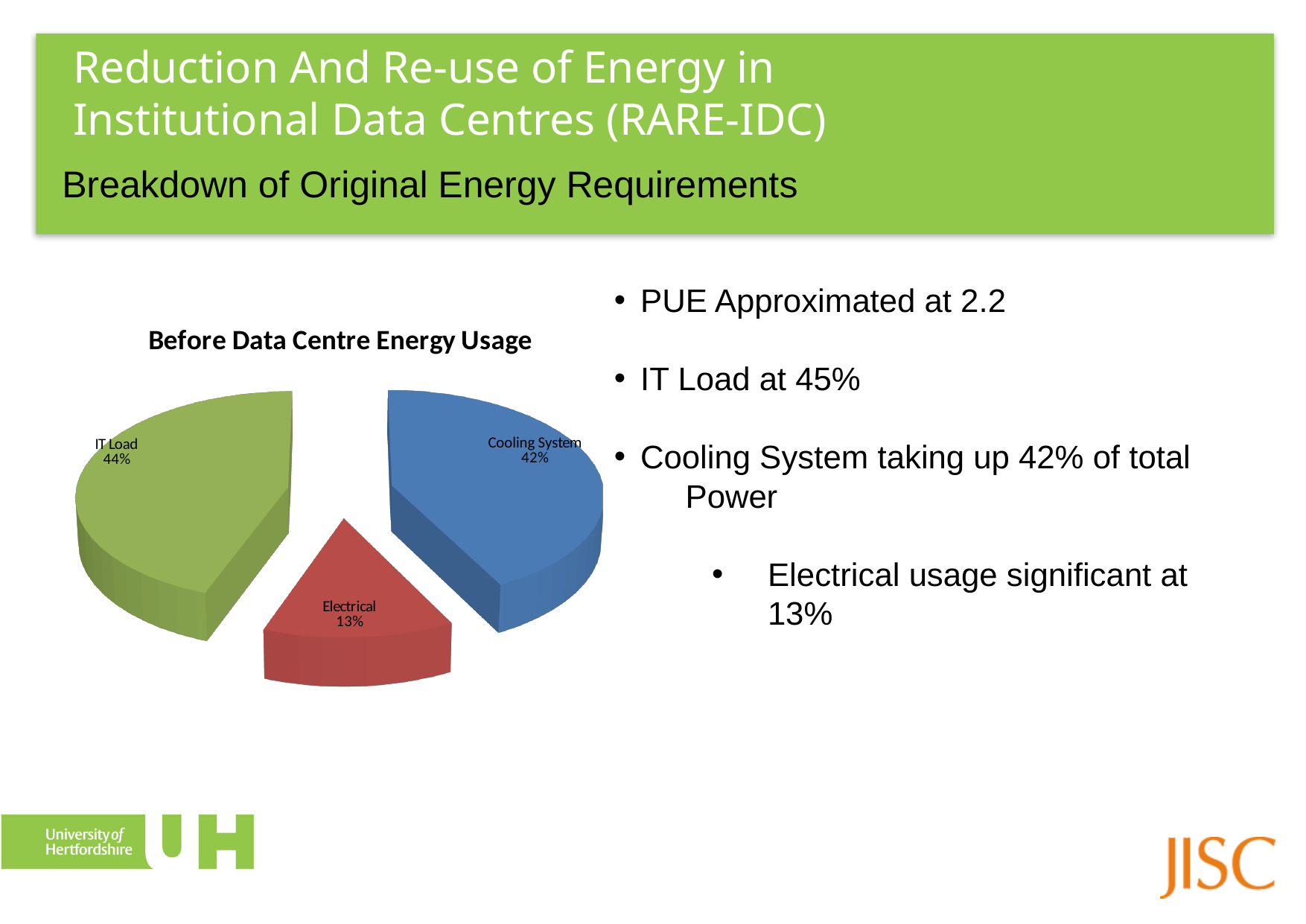
Which is larger, the Cooling System slice or the Electrical slice? Cooling System Which slice of the pie is the largest? IT Load Which slice of the pie is the smallest? Electrical What is the title of the chart? Before Data Centre Energy Usage What colour is the Electrical slice of the pie? Red What is the difference in percentage points between the IT Load and Electrical slices? 31 What share of the pie does IT Load take? 44% How many slices does the pie chart have? 3 What share of the pie does Electrical take? 13% What kind of chart is shown on the slide? Pie chart What is the difference in percentage points between the Cooling System and Electrical slices? 29 What share of the pie does the Cooling System take? 42%